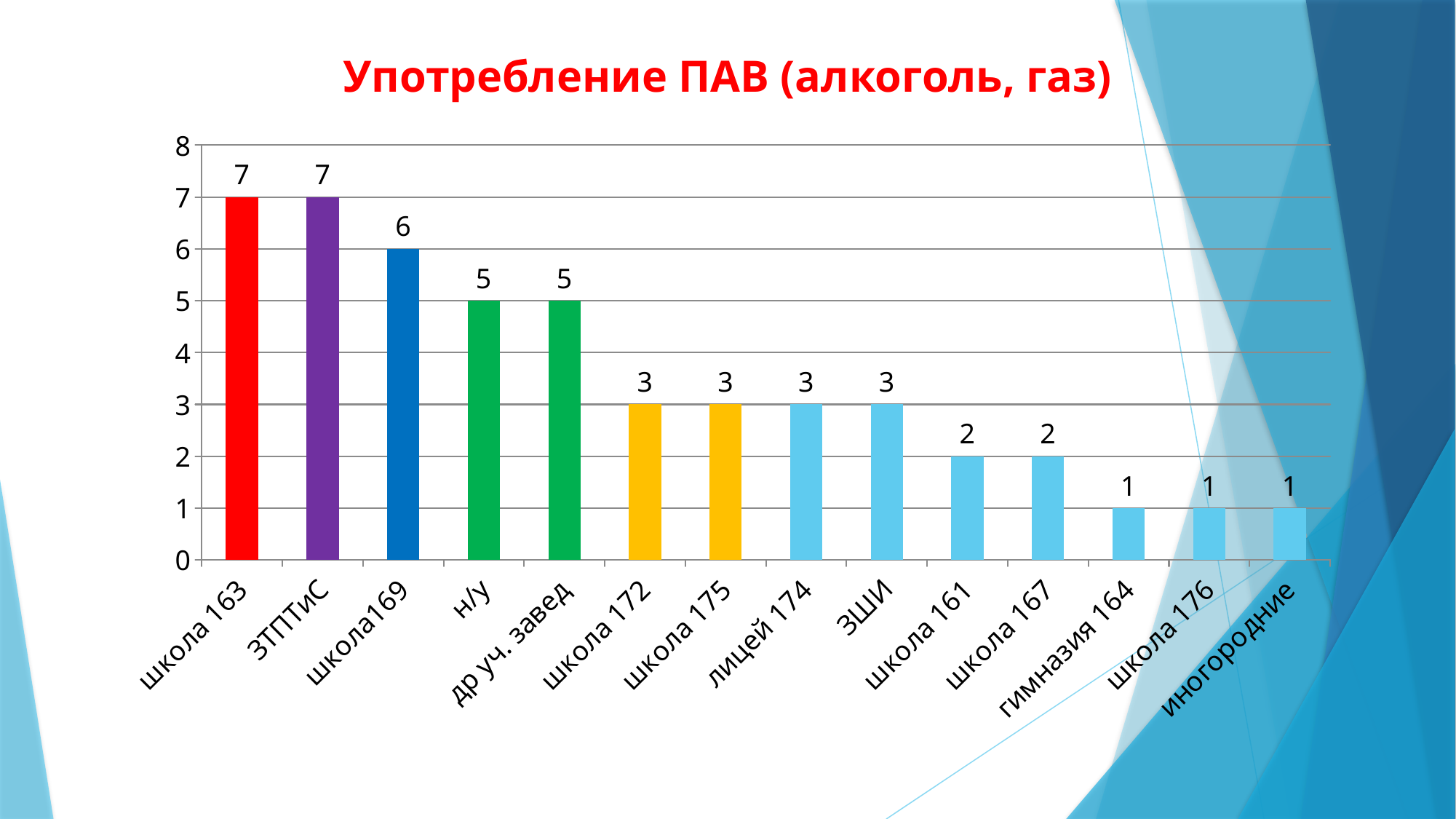
What kind of chart is shown on the slide? bar chart What is the value for лицей 174? 3 What is the value for школа 161? 2 What is the difference between the values for н/у and школа 167? 3 Which is larger, the value for школа169 or the value for ЗШИ? школа169 What is the value for школа 163? 7 What is the difference between the values for школа 163 and школа 172? 4 How many categories are shown on the x axis? 14 What is the title of the chart? Употребление ПАВ (алкоголь, газ) What is the value for школа169? 6 Which is larger, the value for школа 176 or the value for школа 175? школа 175 What is the value for гимназия 164? 1